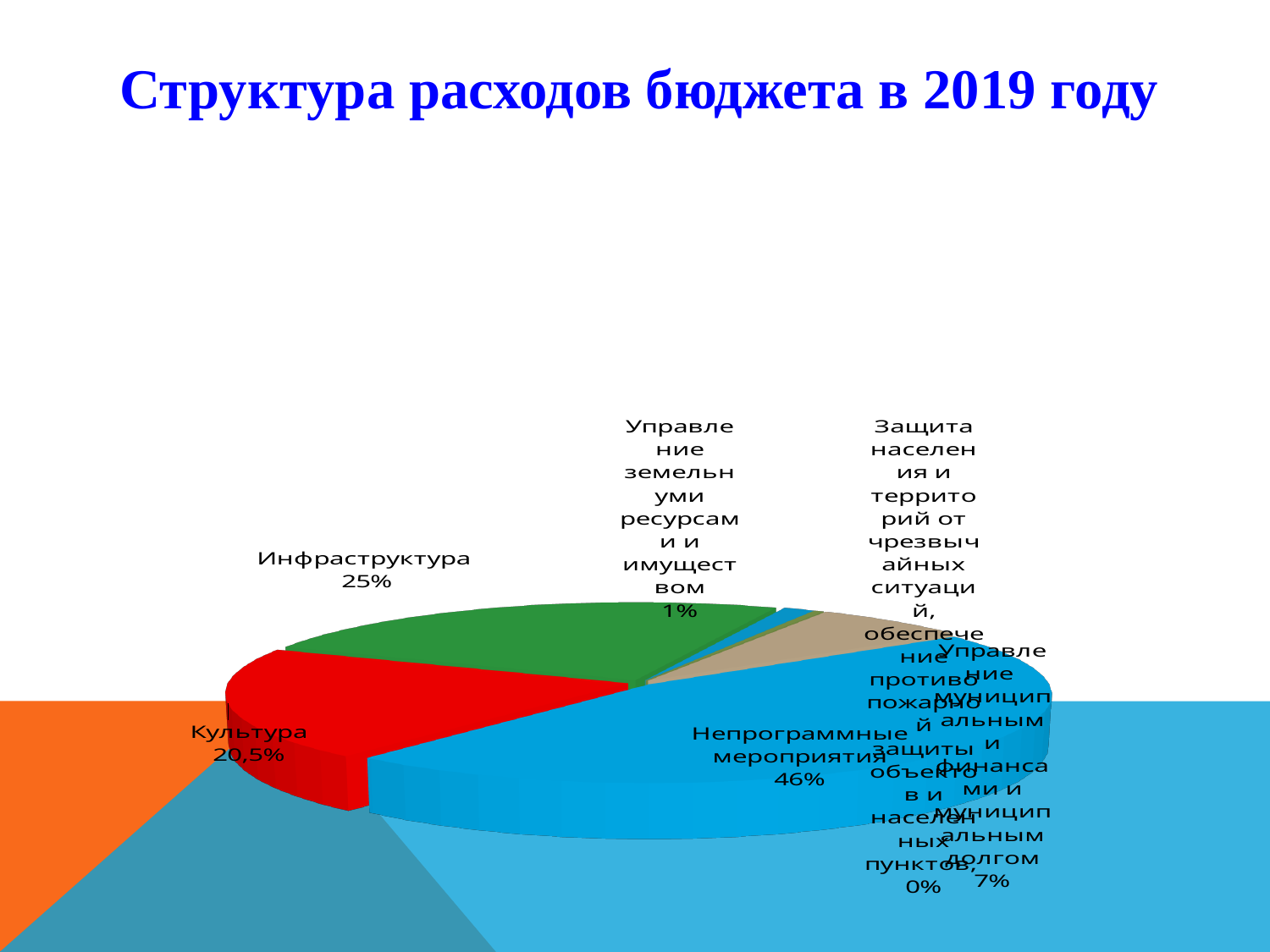
What share is shown for Управление муниципальными финансами и муниципальным долгом? 7% What is the title of the chart? Структура расходов бюджета в 2019 году Which is larger, the share for Инфраструктура or the share for Культура? Инфраструктура What kind of chart is shown on the slide? pie chart What share of the budget expenditure goes to Непрограммные мероприятия? 46% What share is shown for Управление земельными ресурсами и имуществом? 1% Which category has the smallest share of the budget expenditure? Защита населения и территорий от чрезвычайных ситуаций, обеспечение противопожарной защиты объектов и населенных пунктов What is the difference in percentage points between Непрограммные мероприятия and Инфраструктура? 21 Which category has the largest share of the budget expenditure? Непрограммные мероприятия What share of the budget expenditure goes to Культура? 20,5% What share of the budget expenditure goes to Инфраструктура? 25% How many categories are shown in the pie chart? 6